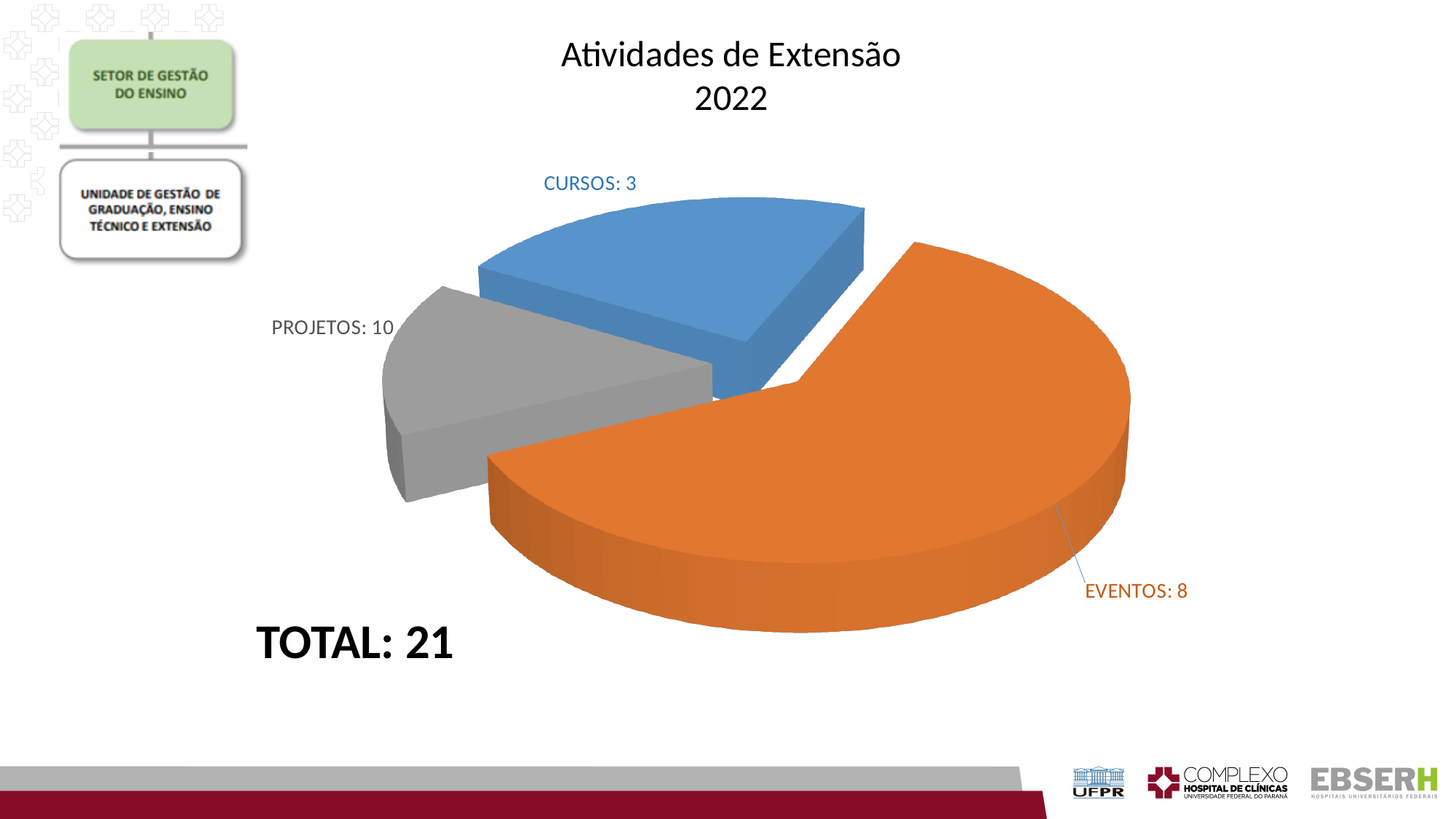
What is the difference between the values for PROJETOS and EVENTOS? 2 What is the total of all the slices in the pie chart, as printed on the slide? 21 How many CURSOS are shown in the pie chart? 3 Which category is represented by the orange slice? EVENTOS What is the value for PROJETOS in the pie chart? 10 What is the title of the chart? Atividades de Extensão 2022 What kind of chart is shown on the slide? Pie chart How many categories (slices) does the pie chart have? 3 What is the value for EVENTOS in the pie chart? 8 What is the difference between the values for EVENTOS and CURSOS? 5 What is the difference between the values for PROJETOS and CURSOS? 7